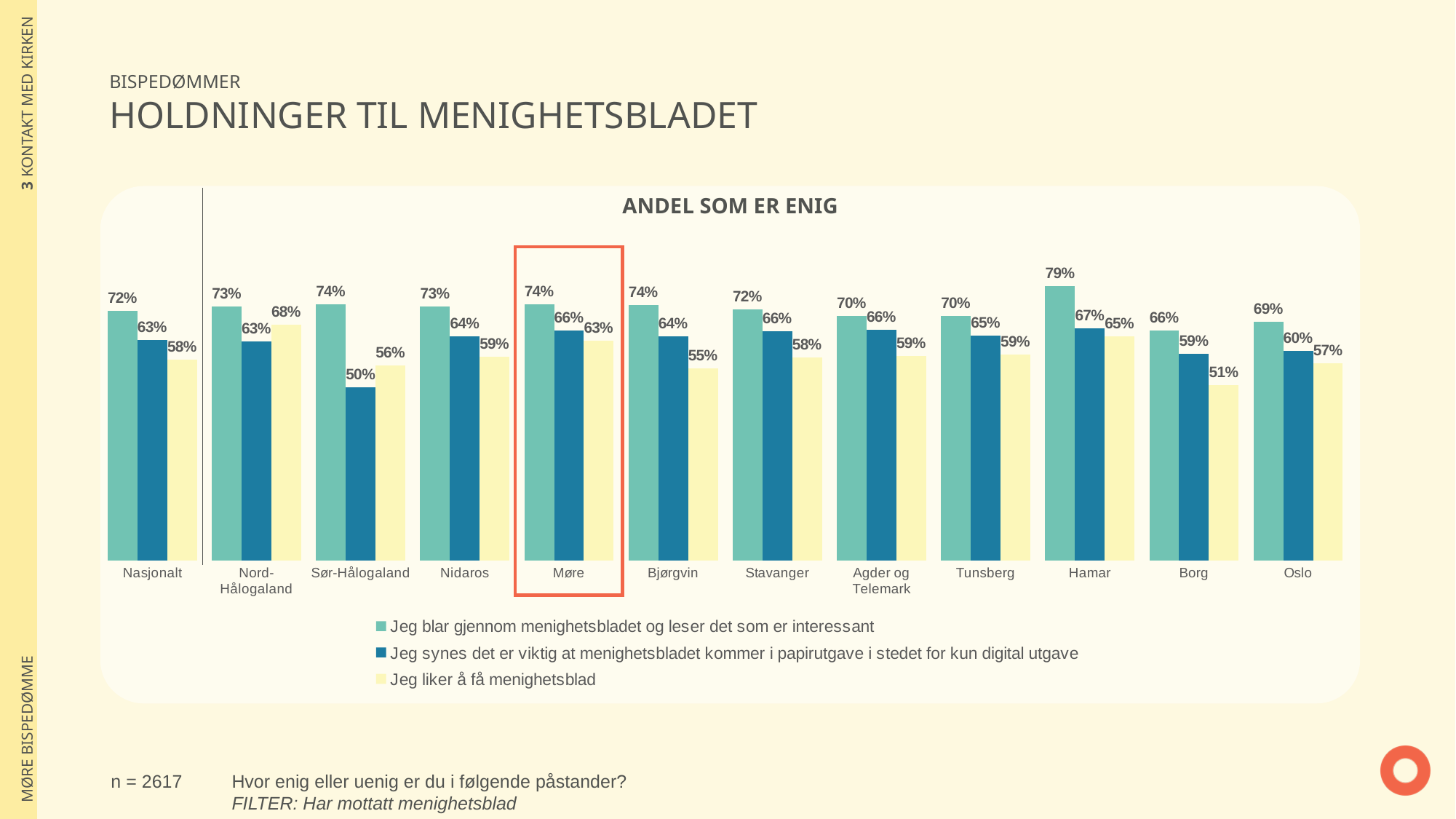
Which category has the lowest value in the series "Jeg liker å få menighetsblad"? Borg What is the value for Hamar in the series "Jeg blar gjennom menighetsbladet og leser det som er interessant"? 79% Which category has the highest value in the series "Jeg blar gjennom menighetsbladet og leser det som er interessant"? Hamar What is the difference between the "Jeg blar gjennom menighetsbladet og leser det som er interessant" value and the "Jeg liker å få menighetsblad" value for Sør-Hålogaland? 18 percentage points What kind of chart is shown on the slide? Bar chart Which category has the highest value in the series "Jeg liker å få menighetsblad"? Nord-Hålogaland What is the value for Møre in the series "Jeg liker å få menighetsblad"? 63% How many series does the legend list? 3 How many categories (bispedømmer including Nasjonalt) are shown on the x axis? 12 What is the title of the chart? ANDEL SOM ER ENIG Which is larger for Nord-Hålogaland: the value for "Jeg synes det er viktig at menighetsbladet kommer i papirutgave i stedet for kun digital utgave" or the value for "Jeg liker å få menighetsblad"? Jeg liker å få menighetsblad What is the value for Sør-Hålogaland in the series "Jeg synes det er viktig at menighetsbladet kommer i papirutgave i stedet for kun digital utgave"? 50%